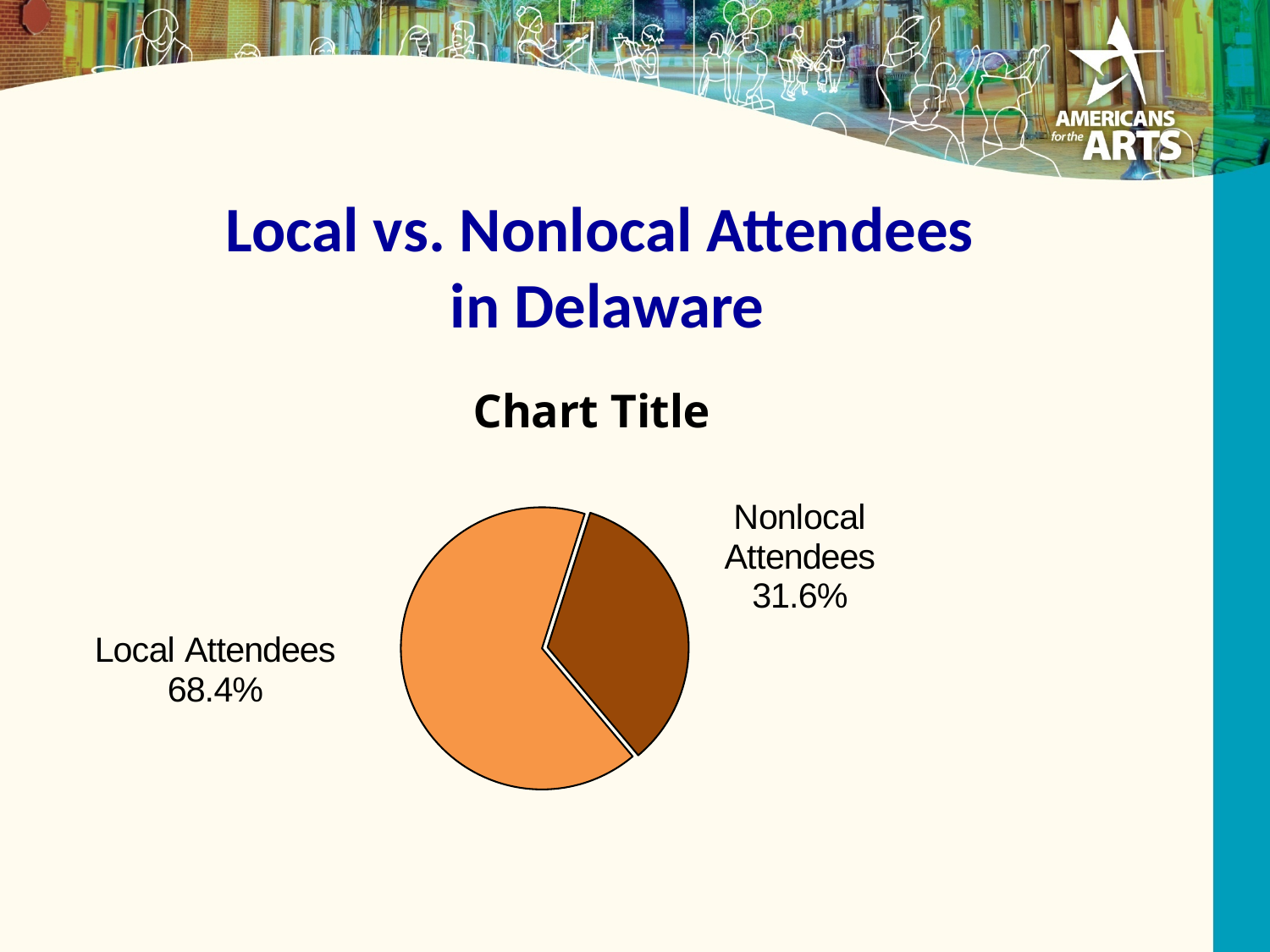
How many slices does the pie chart have? 2 What is the title printed directly above the pie chart? Chart Title What kind of chart is shown on the slide? Pie chart Which slice of the pie is the smallest? Nonlocal Attendees What is the difference in percentage points between Local Attendees and Nonlocal Attendees? 36.8 Which slice of the pie is the largest? Local Attendees What colour is the Nonlocal Attendees slice? Dark brown Which is larger, the share of Local Attendees or the share of Nonlocal Attendees? Local Attendees What share of attendees are Local Attendees? 68.4% What share of attendees are Nonlocal Attendees? 31.6%